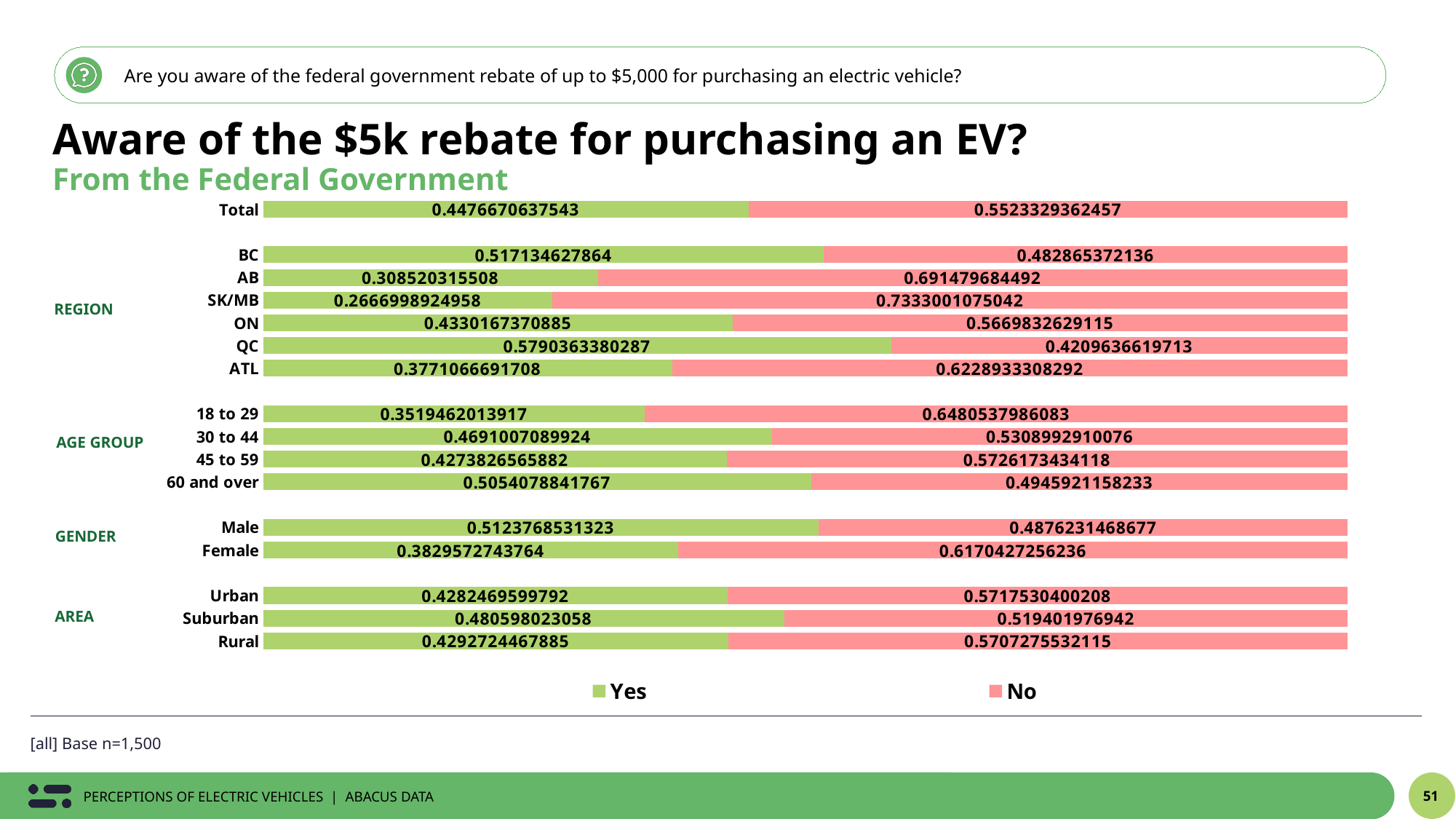
What is the No value for SK/MB? 0.7333001075042 What is the total of the stacked bar for Total? 1 How many categories are shown in the chart? 16 What is the Yes value for Total? 0.4476670637543 What is the No value for Female? 0.6170427256236 Which category has the highest Yes value? QC What is the Yes value for 60 and over? 0.5054078841767 Which category has the lowest Yes value? SK/MB Which has a larger Yes value, Suburban or Urban? Suburban What is the difference between the Yes values for Male and Female? 0.1294195787559 What kind of chart is shown on the slide? Stacked bar chart How many series does the legend list? 2